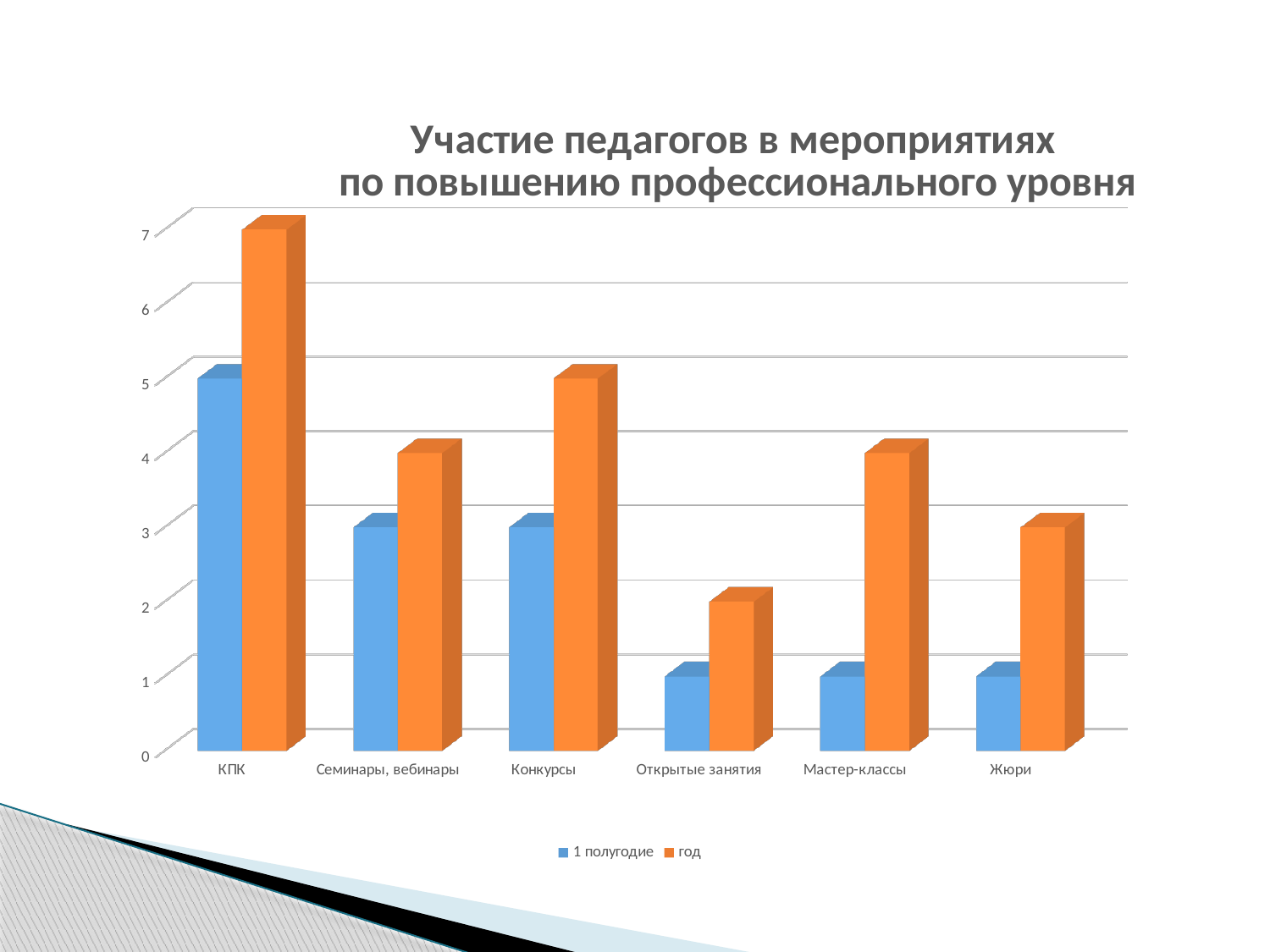
Which is larger for Жюри: the '1 полугодие' value or the 'год' value? год Which category has the highest value for the '1 полугодие' series? КПК What kind of chart is shown on the slide? bar chart What is the 'год' value for КПК? 7 How many series does the legend list? 2 What is the difference between the 'год' and '1 полугодие' values for Мастер-классы? 3 Which category has the lowest value for the 'год' series? Открытые занятия What are the two series named in the legend? 1 полугодие, год Is the 'год' value for Мастер-классы greater or less than 3? greater What is the '1 полугодие' value for Конкурсы? 3 How many categories are shown on the x axis? 6 Which category has the highest value for the 'год' series? КПК